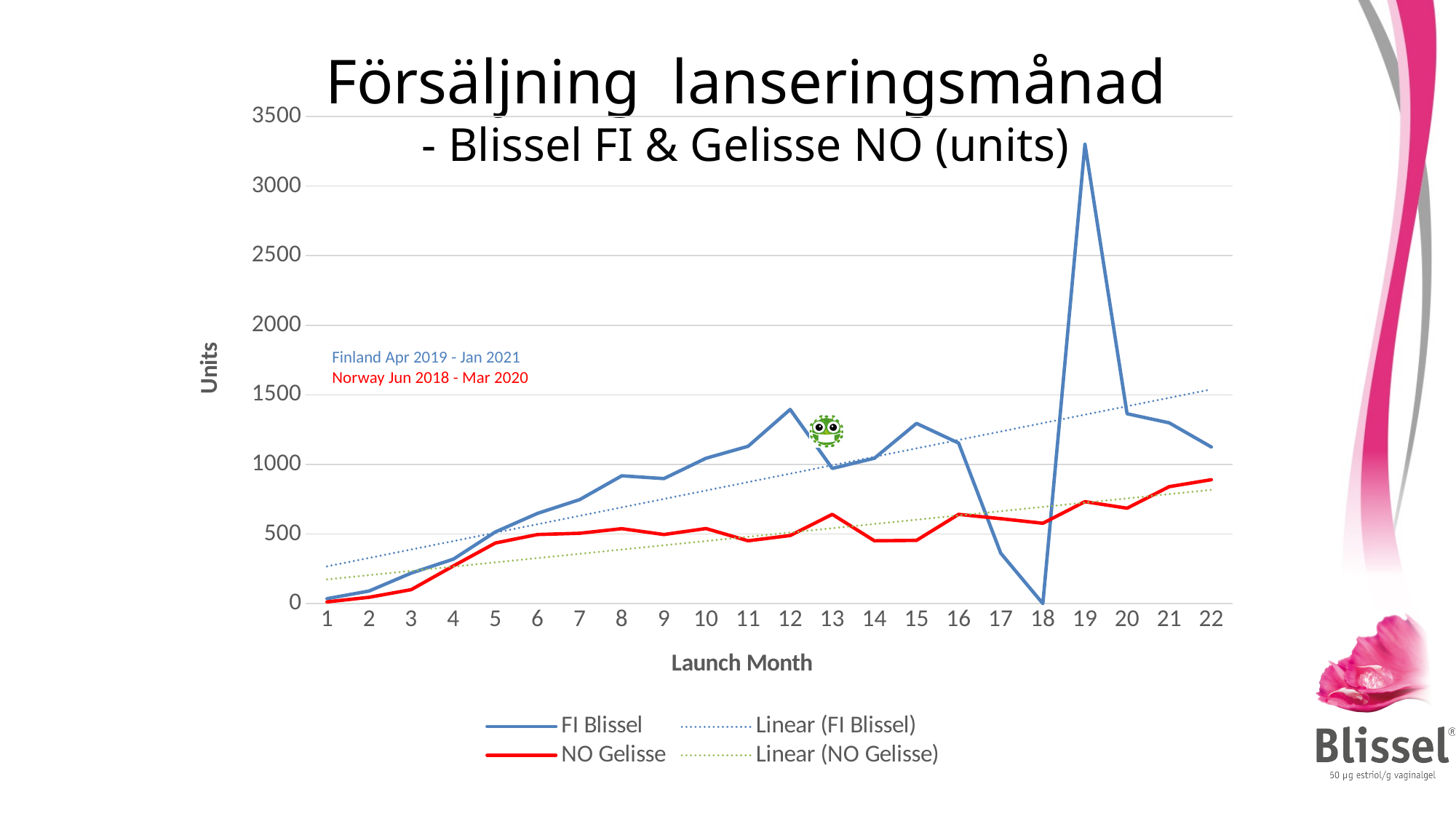
What kind of chart is shown on the slide? line chart In launch month 18, which series has the larger value, FI Blissel or NO Gelisse? NO Gelisse What colour is the line for NO Gelisse? red How many launch months are plotted along the x axis? 22 How many entries does the legend list? 4 Is the value for NO Gelisse in launch month 22 greater or less than 1000? less In which launch month does FI Blissel reach its highest value? 19 In launch month 19, which series has the larger value, FI Blissel or NO Gelisse? FI Blissel Is the value for FI Blissel in launch month 19 greater or less than 3000? greater Does the NO Gelisse series generally rise or fall from launch month 1 to launch month 22? rise In which launch month does FI Blissel reach its lowest value? 18 Is the value for FI Blissel in launch month 18 greater or less than 500? less